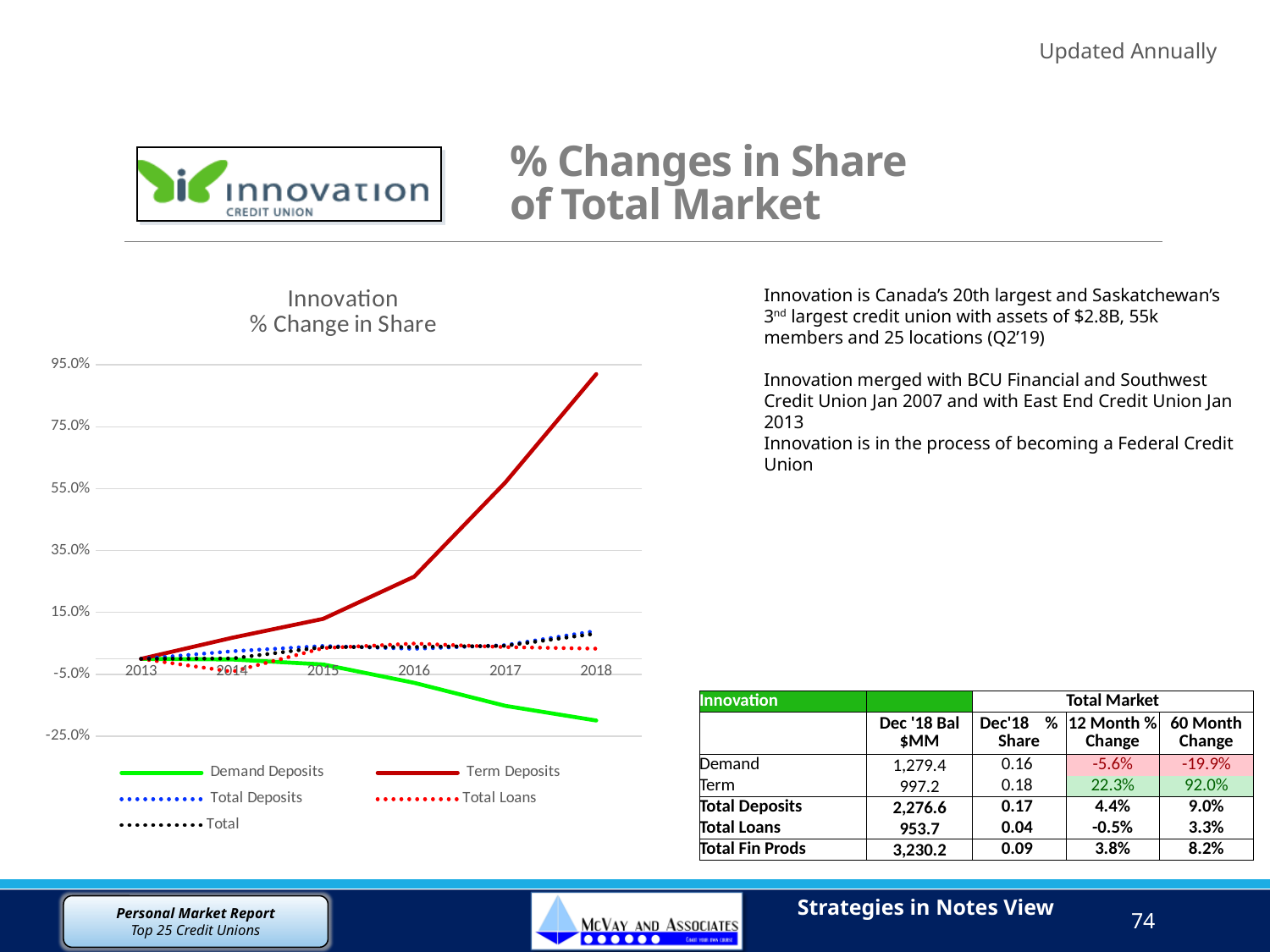
What kind of chart is shown on the slide? line chart In 2018, which is larger: Term Deposits or Demand Deposits? Term Deposits Is the value for Demand Deposits in 2018 greater or less than -5.0%? less What is the title of the chart? Innovation % Change in Share Is the value for Term Deposits in 2016 greater or less than 15.0%? greater Do the values for Demand Deposits rise or fall from 2015 to 2018? fall Which series has the highest value in 2018? Term Deposits How many series does the chart legend list? 5 Do the values for Term Deposits rise or fall from 2013 to 2018? rise How many years are shown along the x axis of the chart? 6 Which series has the lowest value in 2018? Demand Deposits Is the value for Term Deposits in 2018 greater or less than 75.0%? greater